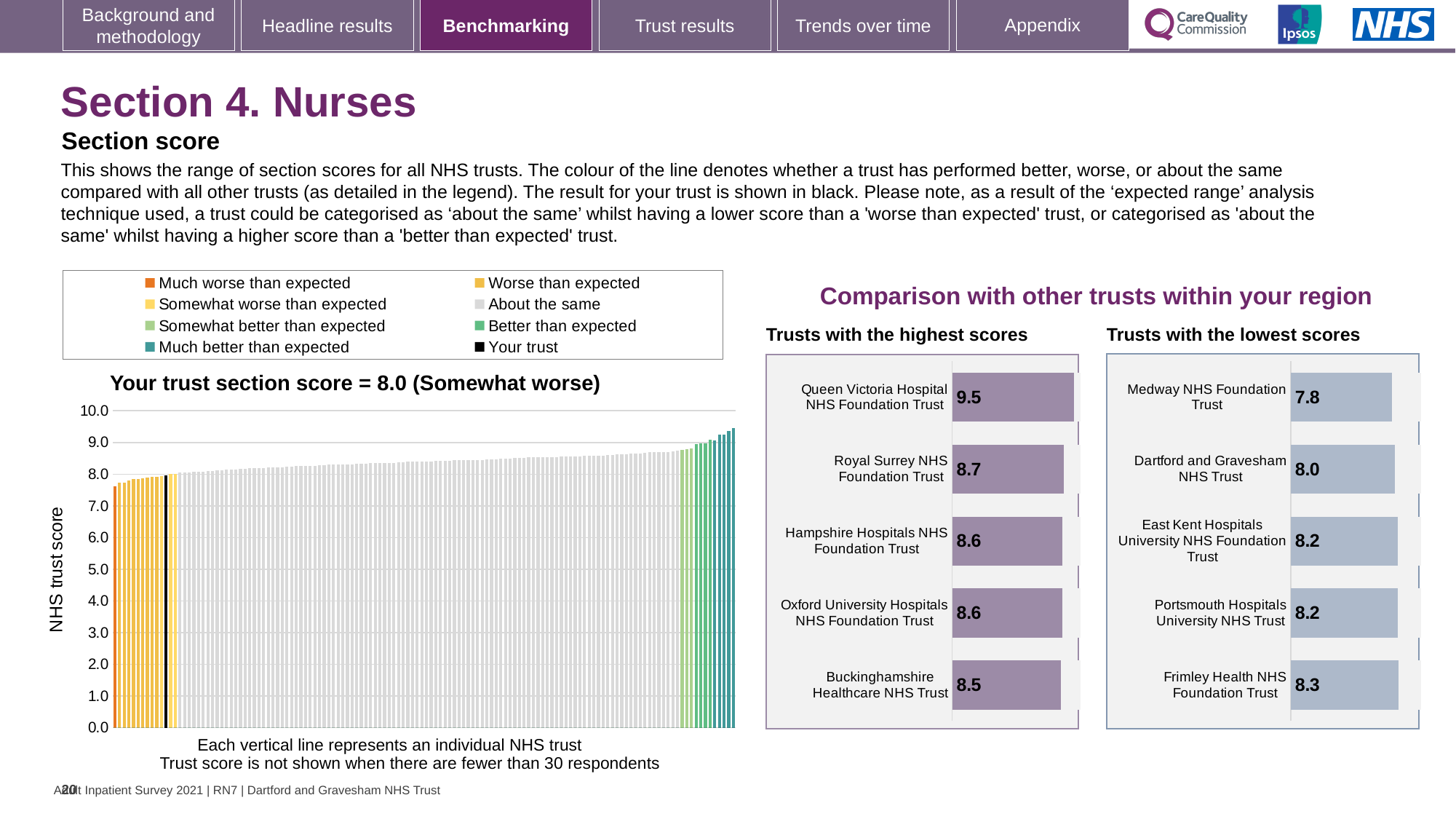
In the 'Trusts with the lowest scores' chart, which trust has the lowest score? Medway NHS Foundation Trust In the 'Trusts with the highest scores' chart, what is the score for Buckinghamshire Healthcare NHS Trust? 8.5 In the main chart on the left, what is your trust's section score? 8.0 In the 'Trusts with the lowest scores' chart, which has the higher score: Dartford and Gravesham NHS Trust or Frimley Health NHS Foundation Trust? Frimley Health NHS Foundation Trust In the 'Trusts with the lowest scores' chart, what is the score for Medway NHS Foundation Trust? 7.8 What kind of chart is the main chart on the left showing all NHS trusts? Bar chart In the 'Trusts with the highest scores' chart, which trust has the highest score? Queen Victoria Hospital NHS Foundation Trust In the 'Trusts with the lowest scores' chart, what is the score for Frimley Health NHS Foundation Trust? 8.3 In the 'Trusts with the highest scores' chart, what is the score for Queen Victoria Hospital NHS Foundation Trust? 9.5 In the 'Trusts with the highest scores' chart, what is the difference between the scores of Queen Victoria Hospital NHS Foundation Trust and Royal Surrey NHS Foundation Trust? 0.8 How many entries does the legend above the main chart on the left list? 8 How many trusts are shown in the 'Trusts with the lowest scores' chart? 5